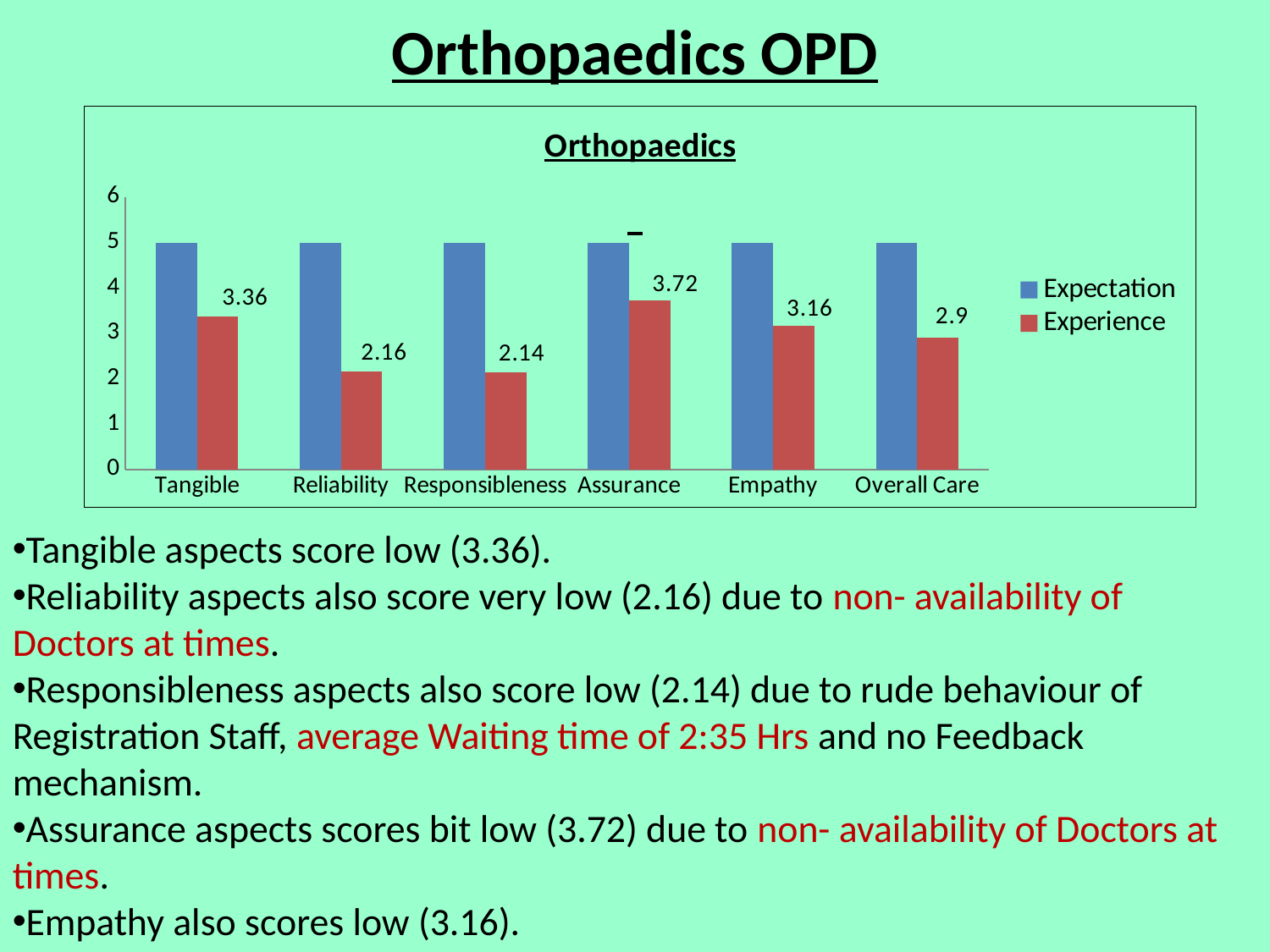
How many categories are shown on the x axis? 6 What is the Experience value for Assurance? 3.72 What is the Experience value for Overall Care? 2.9 Which category has the lowest Experience value? Responsibleness What kind of chart is shown? bar chart What is the Experience value for Tangible? 3.36 What is the difference between the Experience values for Assurance and Empathy? 0.56 How many series does the legend list? 2 Which category has the highest Experience value? Assurance Is the Expectation value for Tangible greater or less than 4? greater What is the Experience value for Reliability? 2.16 Which has a larger Experience value, Tangible or Overall Care? Tangible